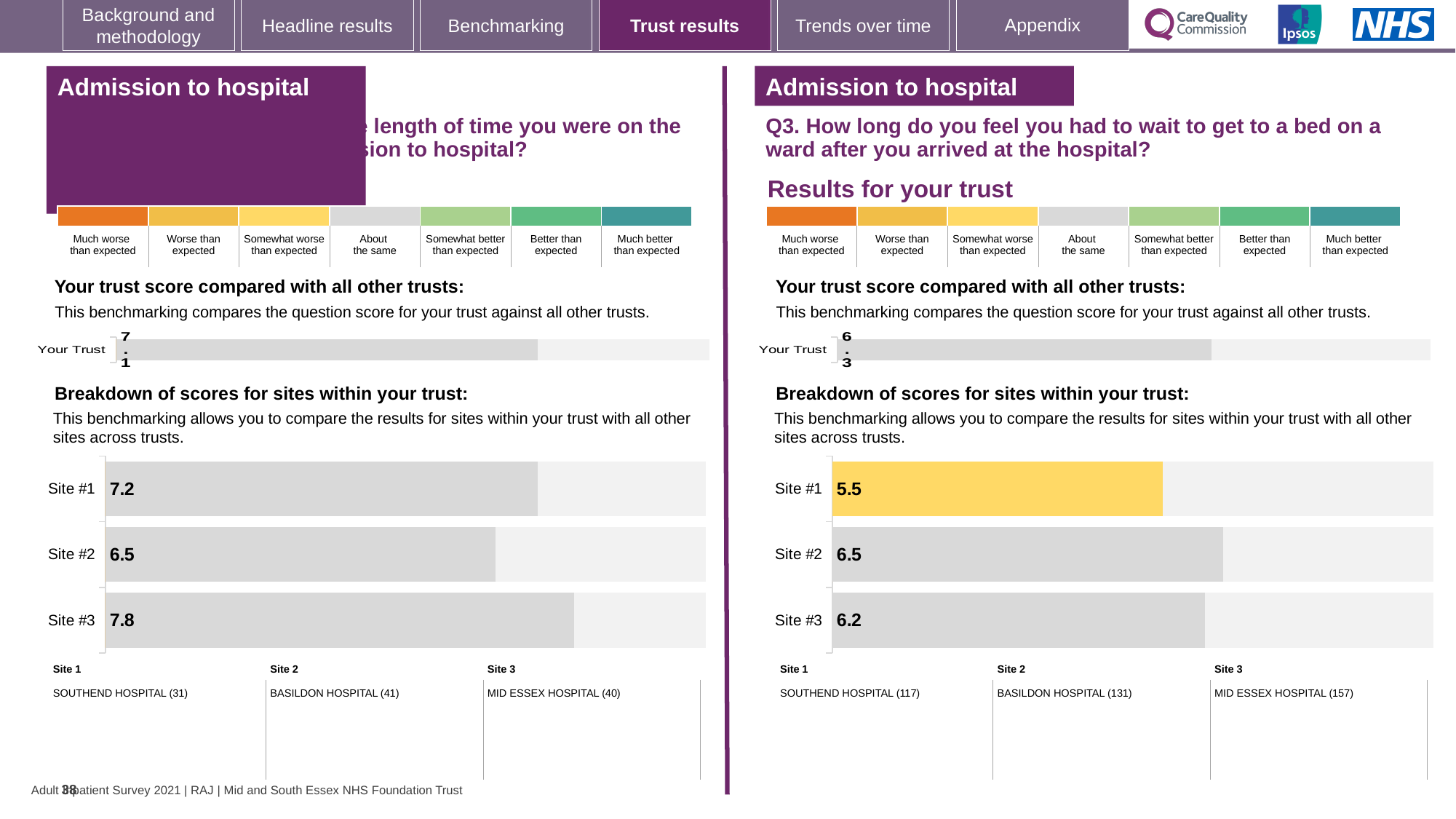
On the left-hand site breakdown chart, what is the score for Site #1? 7.2 On the right-hand (Q3) site breakdown chart, what is the score for Site #3? 6.2 What type of chart is the left-hand site breakdown chart? Bar chart On the right-hand (Q3) site breakdown chart, which site has the highest score? Site #2 On the right-hand (Q3) 'Your trust score compared with all other trusts' chart, what is the score for Your Trust? 6.3 How many sites are shown on the right-hand (Q3) site breakdown chart? 3 On the left-hand 'Your trust score compared with all other trusts' chart, what is the score for Your Trust? 7.1 On the right-hand (Q3) site breakdown chart, which site has the lowest score? Site #1 On the left-hand site breakdown chart, which site has the highest score? Site #3 On the left-hand site breakdown chart, what is the difference between the scores for Site #3 and Site #2? 1.3 On the right-hand (Q3) site breakdown chart, what is the difference between the scores for Site #2 and Site #1? 1.0 On the left-hand site breakdown chart, which site has the lowest score? Site #2